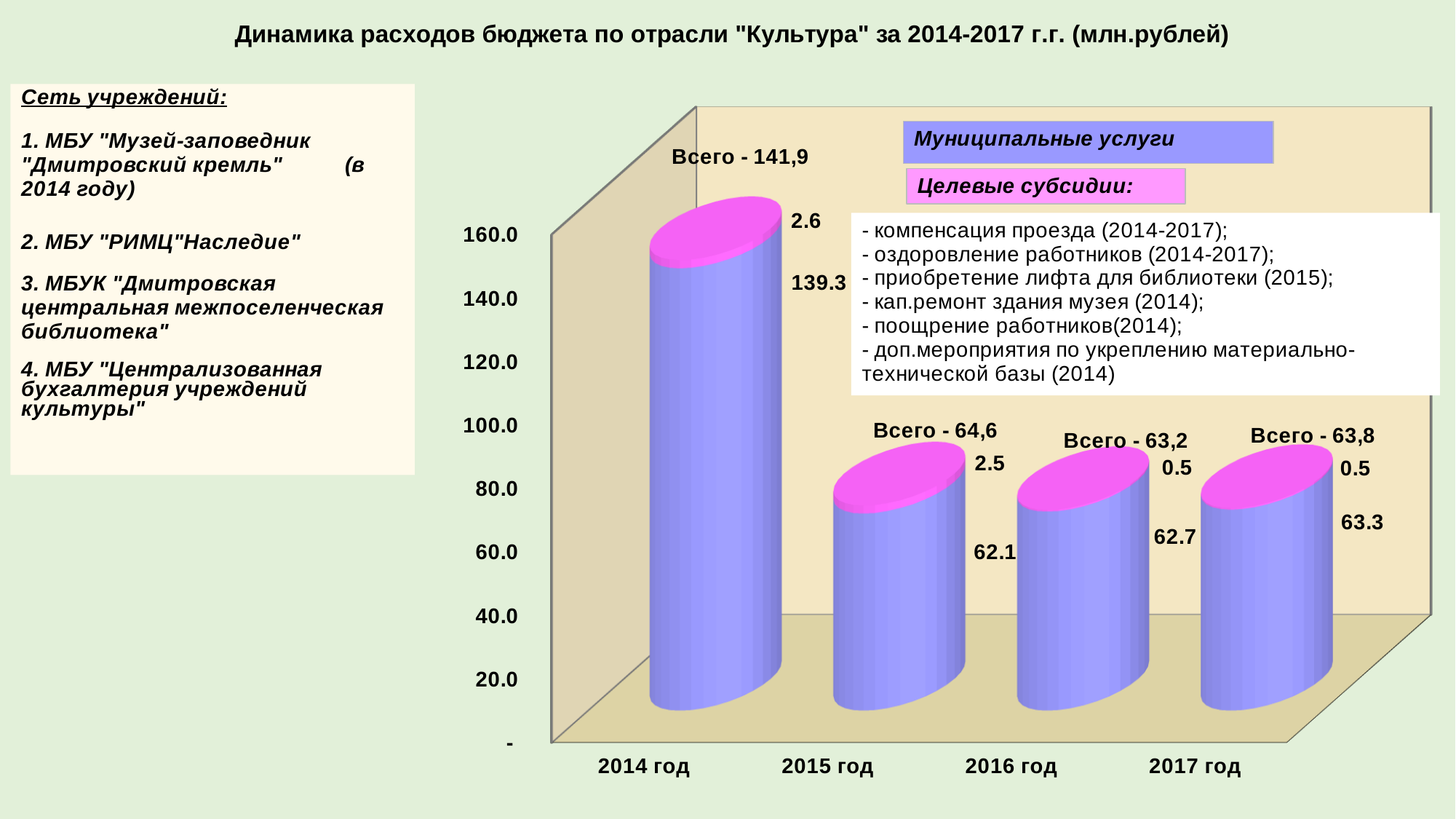
Which year has the lowest total expenditure? 2016 год What is the value of Муниципальные услуги for 2014 год? 139.3 Which is larger: the Целевые субсидии value for 2014 год or for 2016 год? 2014 год What is the total (Всего) shown for 2016 год? 63,2 How many years are shown on the x axis? 4 Which year has the highest total expenditure? 2014 год What is the value of Муниципальные услуги for 2017 год? 63.3 What is the difference between the Муниципальные услуги values for 2014 год and 2015 год? 77.2 Is the total for 2015 год greater or less than 100.0? less What kind of chart is shown on the slide? stacked bar chart How many series does the legend list? 2 What is the value of Целевые субсидии for 2015 год? 2.5